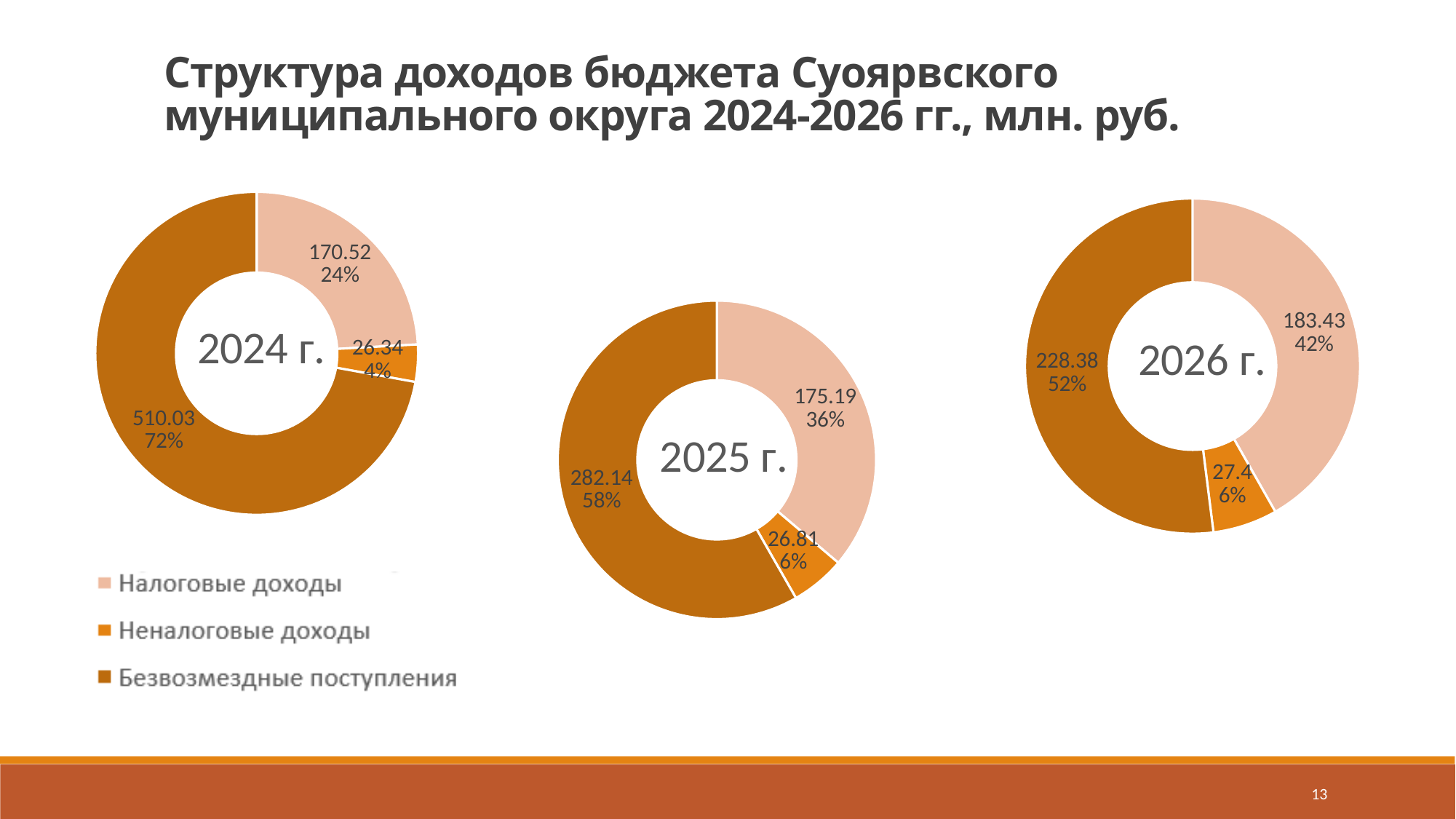
What type of chart is used on this slide? Donut (pie) chart In the 2024 г. chart, what is the value for Безвозмездные поступления? 510.03 In the 2024 г. chart, what is the difference between Безвозмездные поступления and Налоговые доходы? 339.51 In the 2026 г. chart, what is the value for Неналоговые доходы? 27.4 In the 2024 г. chart, what share of the total do Неналоговые доходы make up? 4% In the 2026 г. chart, which category has the smallest value? Неналоговые доходы Which is larger: Налоговые доходы in 2025 г. or Налоговые доходы in 2026 г.? Налоговые доходы in 2026 г. How many categories does each donut chart show? 3 In the 2025 г. chart, which category has the largest value? Безвозмездные поступления Which category is shown in the darkest brown colour in the legend? Безвозмездные поступления In the 2025 г. chart, what is the value for Налоговые доходы? 175.19 In the 2026 г. chart, what share of the total do Налоговые доходы make up? 42%